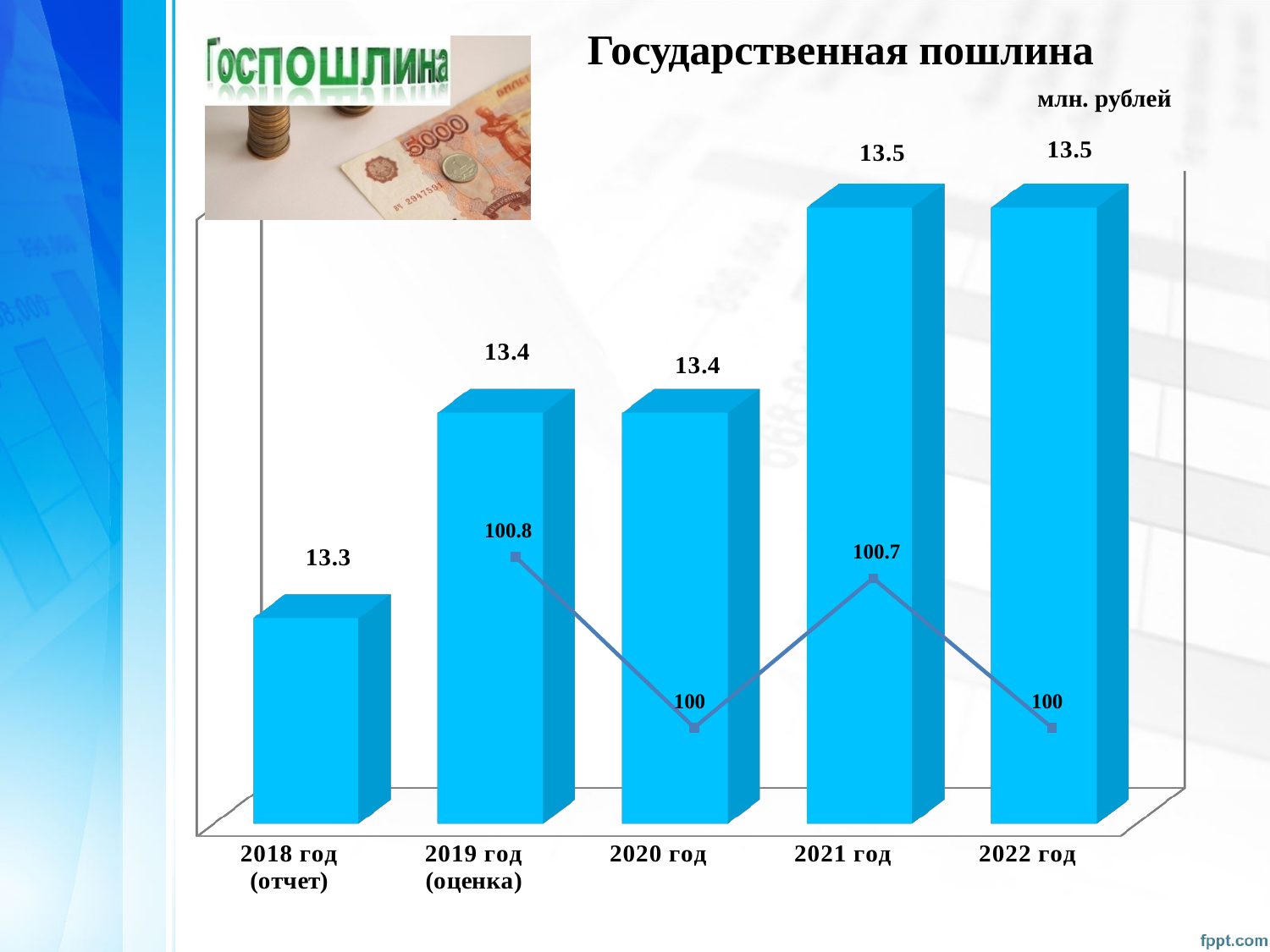
What kind of chart is used to show the values in млн. рублей? Bar chart What is the line value shown for 2021 год? 100.7 What is the value of the bar for 2021 год? 13.5 Which year has the lowest bar value? 2018 год (отчет) What is the value of the bar for 2019 год (оценка)? 13.4 What is the difference between the bar values for 2021 год and 2018 год (отчет)? 0.2 How many years are shown on the x axis? 5 What is the value of the bar for 2022 год? 13.5 Which bar is larger, 2019 год (оценка) or 2018 год (отчет)? 2019 год (оценка) What is the value of the bar for 2018 год (отчет)? 13.3 What is the line value shown for 2019 год (оценка)? 100.8 Do the bar values rise or fall from 2018 год (отчет) to 2022 год? Rise